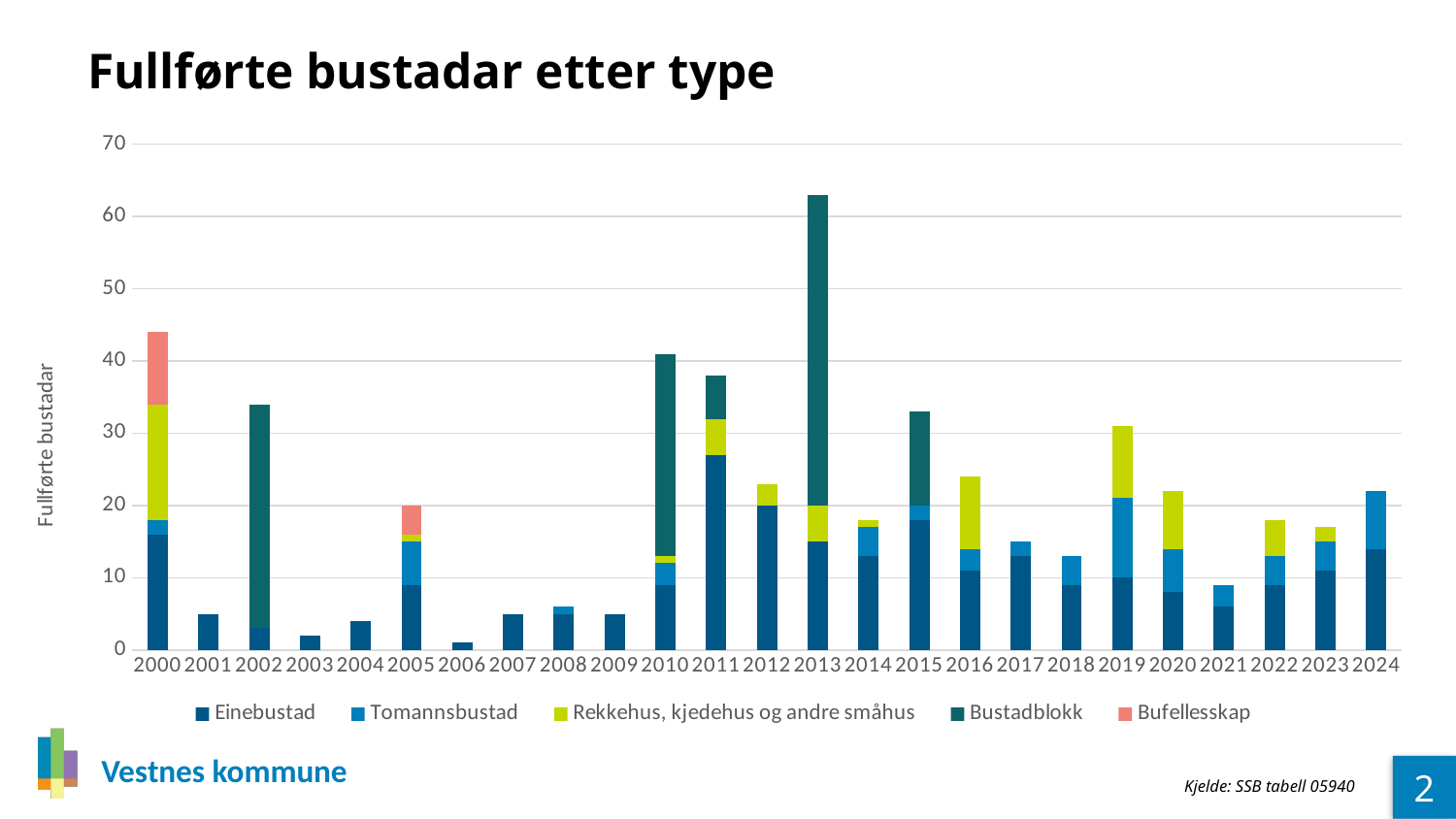
Is the total value for 2000 greater or less than 40? greater Is the total value for 2013 greater or less than 60? greater Is the total value for 2024 greater or less than 20? greater What is the title of the chart? Fullførte bustadar etter type Which series is shown in the light red/salmon colour in the legend? Bufellesskap How many series does the legend list? 5 Which year has the highest total of completed dwellings? 2013 Which year has the lowest total of completed dwellings? 2006 How many years are shown along the x axis? 25 Which year has the larger total, 2002 or 2005? 2002 What kind of chart is shown on the slide? Stacked bar chart